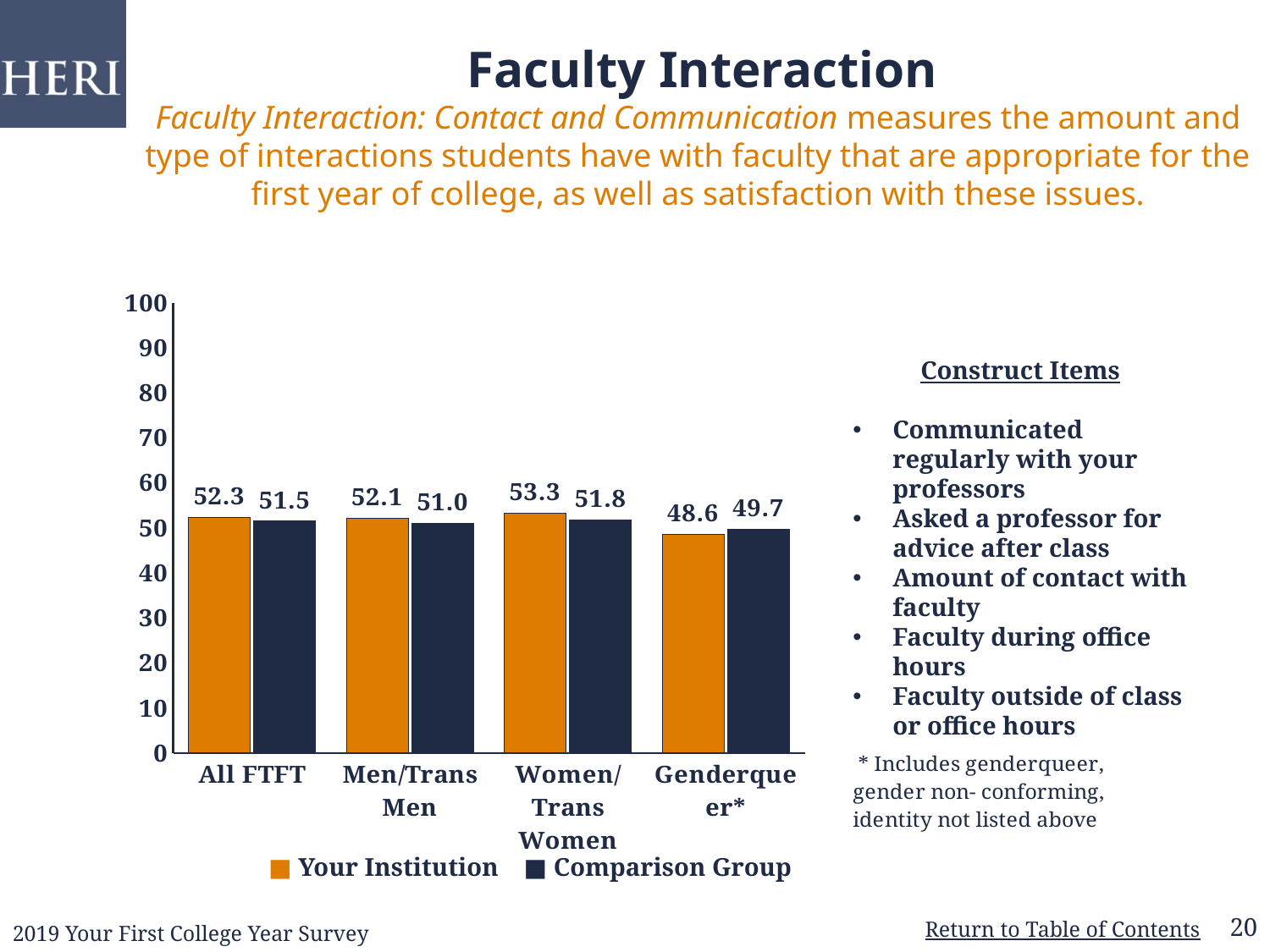
How many series does the legend list? 2 What is the Comparison Group value for Women/Trans Women? 51.8 Which category has the lowest Comparison Group value? Genderqueer* What colour represents Your Institution in the chart? orange How many categories are shown on the x axis? 4 Which category has the highest Your Institution value? Women/Trans Women What kind of chart is shown on the slide? bar chart For Genderqueer*, which is larger: Your Institution or Comparison Group? Comparison Group What is the Your Institution value for All FTFT? 52.3 What is the difference between the Your Institution and Comparison Group values for Men/Trans Men? 1.1 What is the Your Institution value for Genderqueer*? 48.6 Is the Your Institution value for Women/Trans Women greater or less than 50? greater